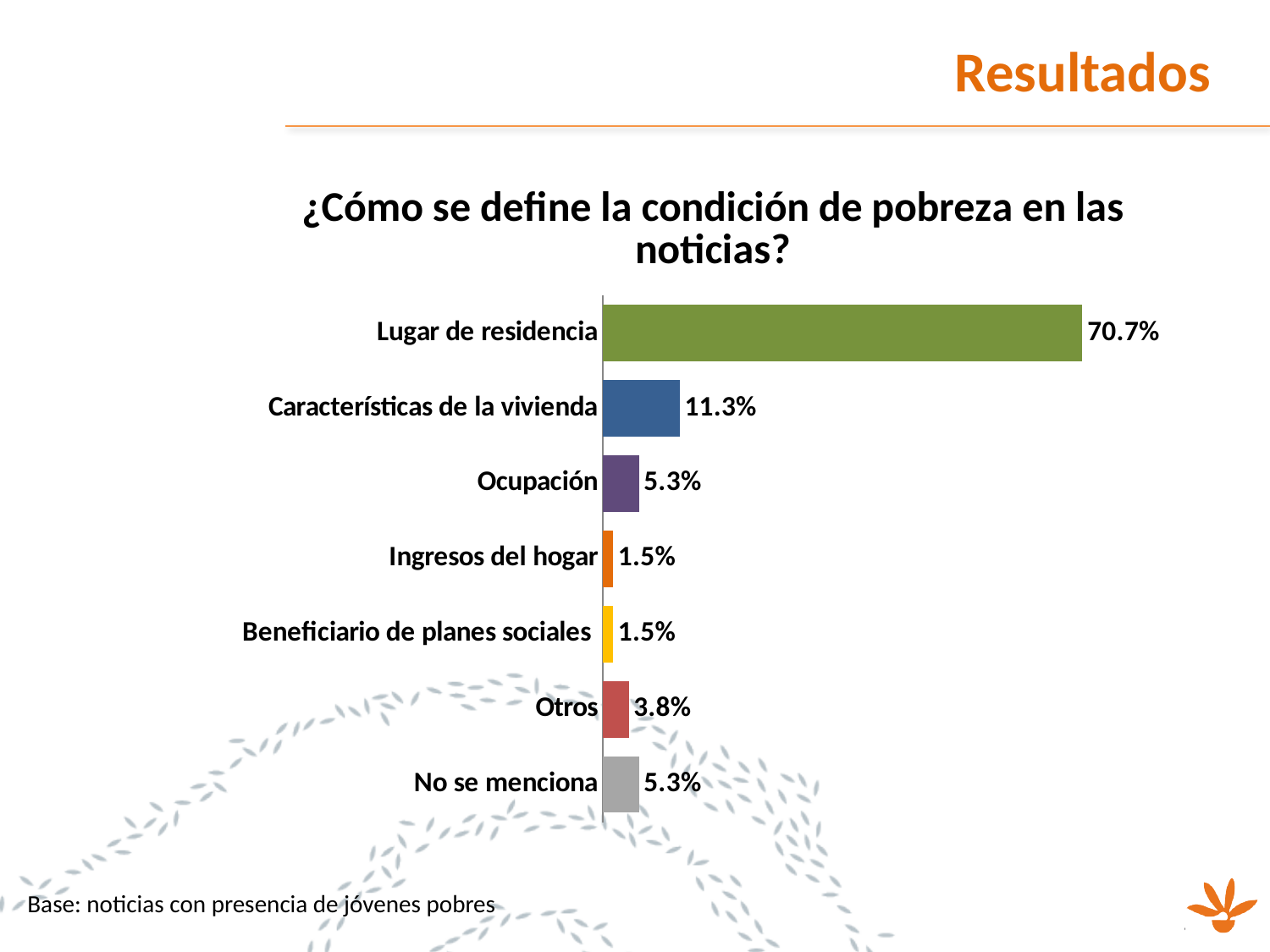
What is the difference between the values for Lugar de residencia and Características de la vivienda? 59.4% What is the value for No se menciona? 5.3% What is the difference between the values for Ocupación and Otros? 1.5% Which category has the highest value? Lugar de residencia Which is larger, the value for Otros or the value for Ingresos del hogar? Otros How many categories are shown in the chart? 7 What kind of chart is shown on the slide? Bar chart What is the title of the chart? ¿Cómo se define la condición de pobreza en las noticias? Which is larger, the value for Características de la vivienda or the value for Ocupación? Características de la vivienda What is the value for Características de la vivienda? 11.3% What is the value for Lugar de residencia? 70.7% What is the value for Otros? 3.8%